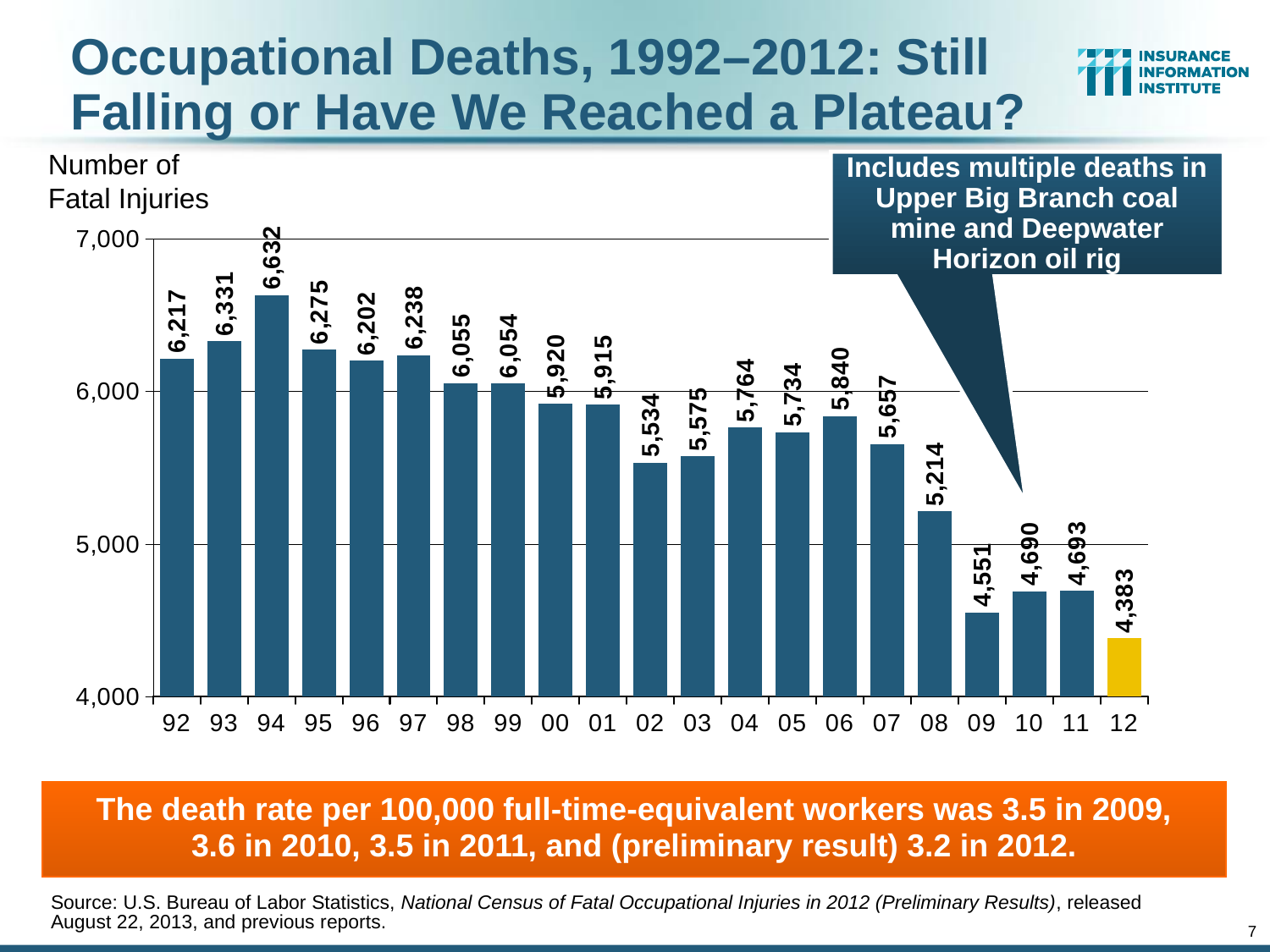
Which year's bar is coloured differently (yellow) from the others? 12 Which year had the highest number of fatal injuries? 94 Is the value for 2002 greater or less than 6,000? less What was the number of fatal injuries in 2008? 5,214 What is the difference in fatal injuries between 2008 and 2009? 663 Which year had more fatal injuries, 2006 or 2007? 2006 What was the number of fatal injuries in 2012? 4,383 How many years are shown on the x axis? 21 What was the number of fatal injuries in 1994? 6,632 Do the values generally rise or fall from 1994 to 2012? Fall What kind of chart is shown on the slide? Bar chart Which year had the lowest number of fatal injuries? 12